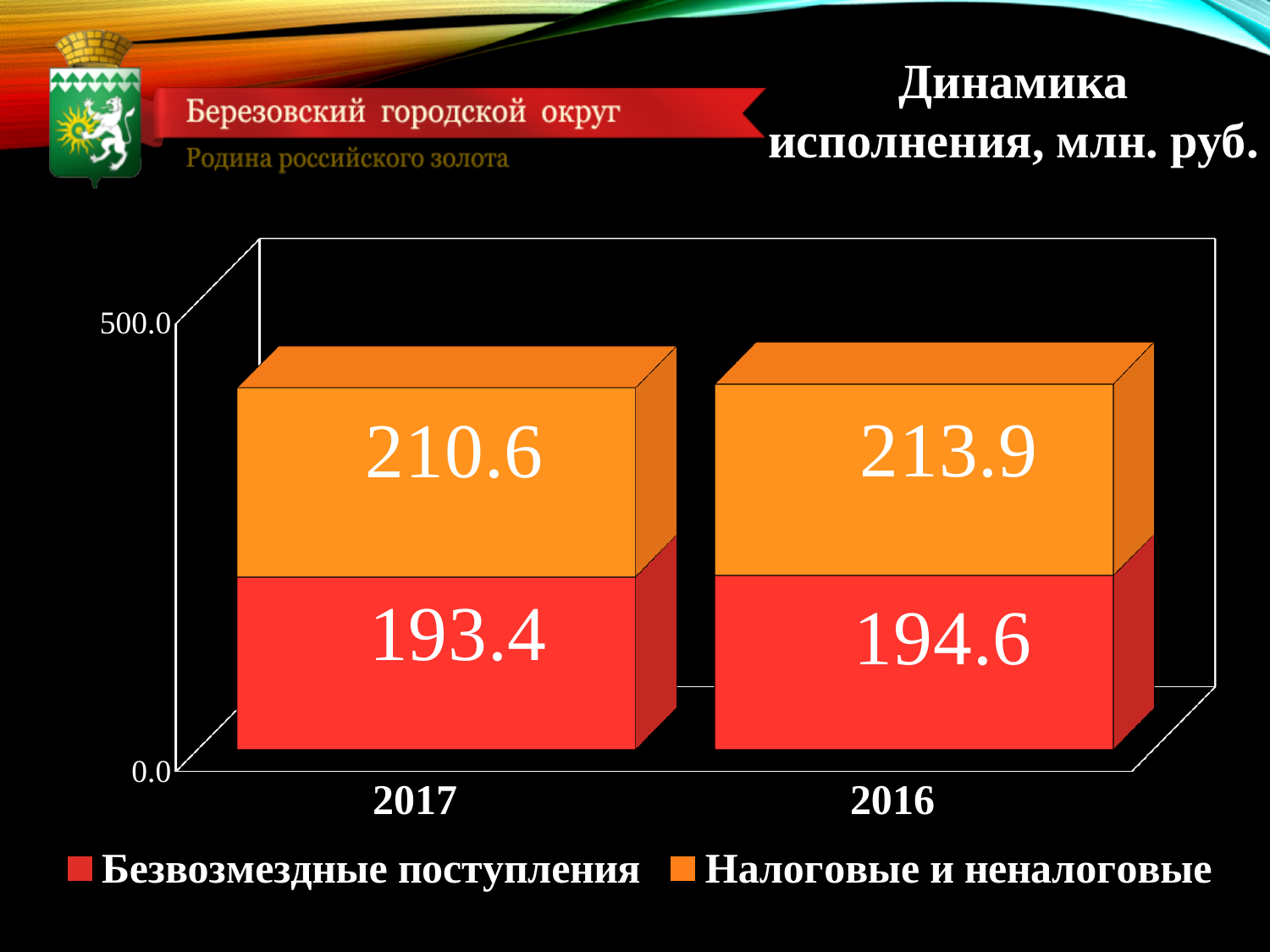
What is the value of Безвозмездные поступления for 2017? 193.4 What is the difference between the Налоговые и неналоговые values for 2016 and 2017? 3.3 What is the total of the stacked bar for 2017? 404.0 Which colour represents Налоговые и неналоговые in the legend? Orange What is the value of Налоговые и неналоговые for 2016? 213.9 What is the value of Налоговые и неналоговые for 2017? 210.6 What is the value of Безвозмездные поступления for 2016? 194.6 How many series does the legend list? 2 Which year has the higher value for Безвозмездные поступления, 2017 or 2016? 2016 What kind of chart is shown on the slide? Stacked bar chart How many categories are shown on the x axis? 2 What is the total of the stacked bar for 2016? 408.5